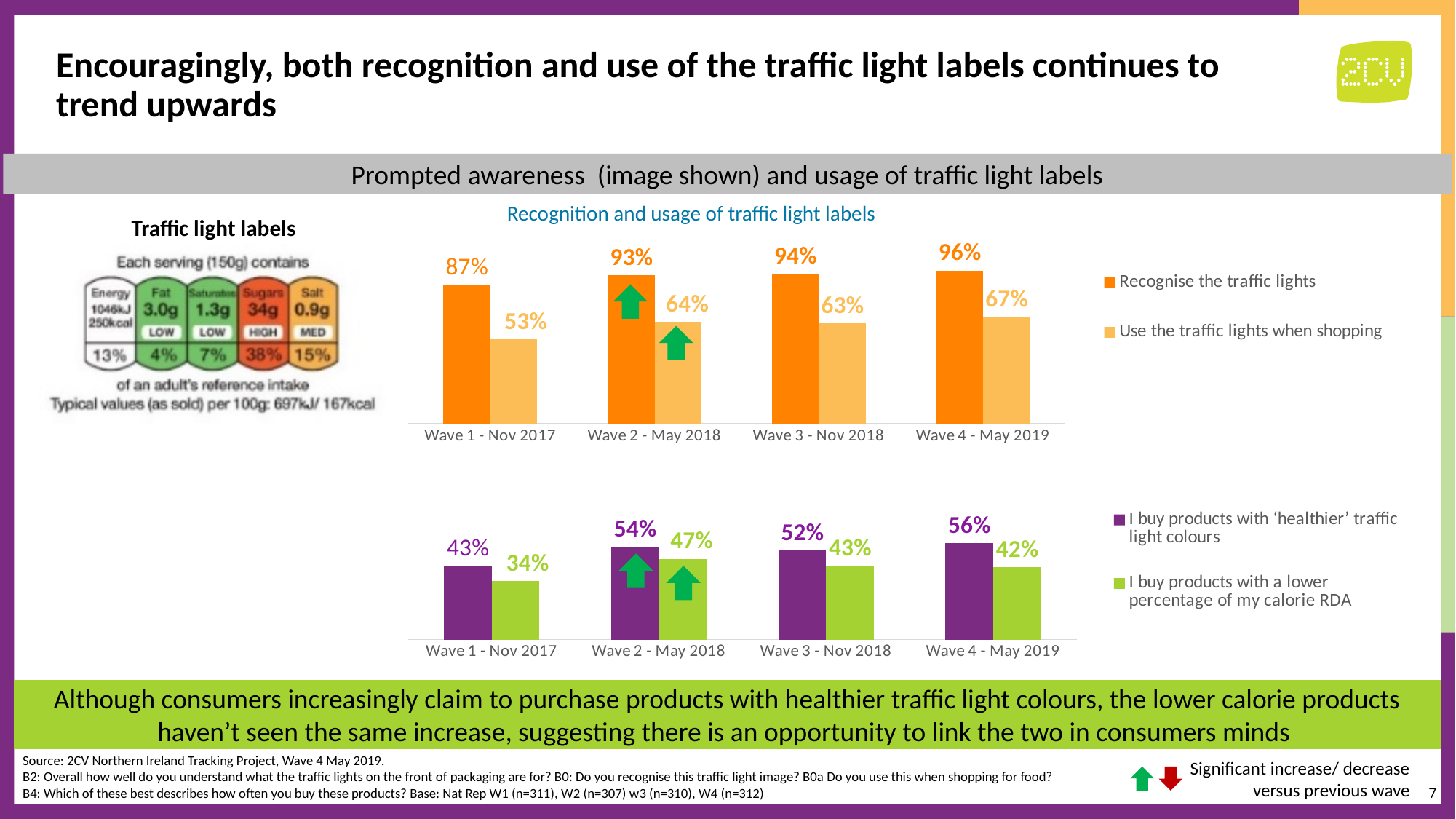
In the top chart 'Recognition and usage of traffic light labels', what is the difference between 'Recognise the traffic lights' and 'Use the traffic lights when shopping' in Wave 2 - May 2018? 29% In the top chart 'Recognition and usage of traffic light labels', which wave has the lowest value for 'Recognise the traffic lights'? Wave 1 - Nov 2017 How many series does the legend of the top chart 'Recognition and usage of traffic light labels' list? 2 In the bottom chart, what is the difference between the two series in Wave 4 - May 2019? 14% In the bottom chart, which wave has the highest value for 'I buy products with ‘healthier’ traffic light colours'? Wave 4 - May 2019 How many waves (categories) are shown on the x axis of the bottom chart? 4 What type of chart is the top chart 'Recognition and usage of traffic light labels'? bar chart In the bottom chart, what is the value for 'I buy products with a lower percentage of my calorie RDA' in Wave 2 - May 2018? 47% In the top chart 'Recognition and usage of traffic light labels', what is the value for 'Use the traffic lights when shopping' in Wave 1 - Nov 2017? 53% In the bottom chart, which is larger in Wave 3 - Nov 2018: 'I buy products with ‘healthier’ traffic light colours' or 'I buy products with a lower percentage of my calorie RDA'? I buy products with ‘healthier’ traffic light colours In the top chart 'Recognition and usage of traffic light labels', what is the value for 'Recognise the traffic lights' in Wave 4 - May 2019? 96% In the top chart 'Recognition and usage of traffic light labels', does the 'Recognise the traffic lights' series rise or fall from Wave 1 to Wave 4? rise